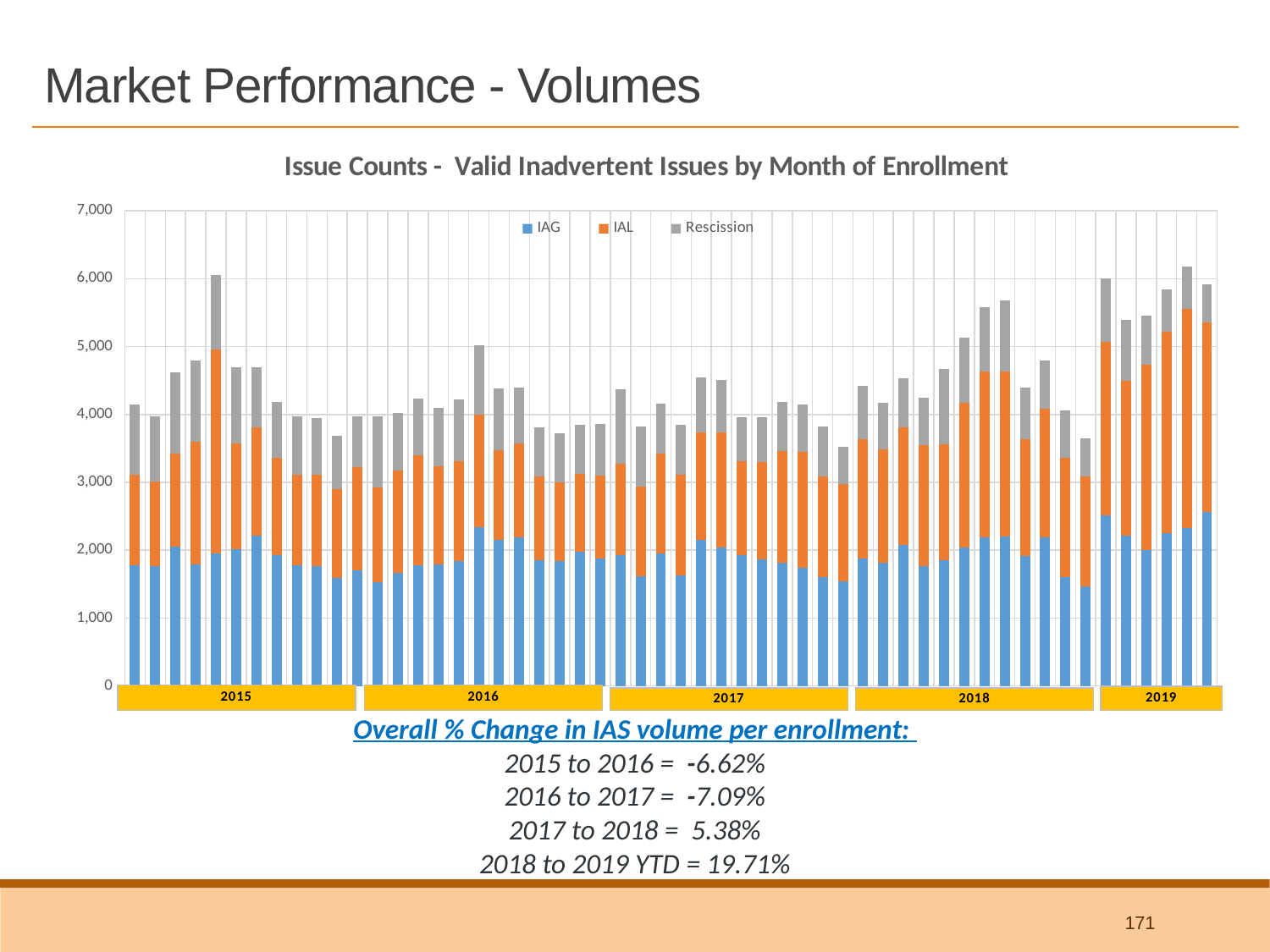
What is the title of the chart? Issue Counts - Valid Inadvertent Issues by Month of Enrollment Which is larger: the tallest bar in the 2019 group or the tallest bar in the 2017 group? The tallest bar in the 2019 group Is the IAG value of the last bar in the 2019 group greater or less than 2,000? greater According to the text below the chart, what is the overall % change in IAS volume per enrollment from 2016 to 2017? -7.09% Is the total of the last bar in the 2019 group greater or less than 5,000? greater Which series is plotted at the bottom of each stacked bar? IAG According to the text below the chart, what is the overall % change in IAS volume per enrollment from 2018 to 2019 YTD? 19.71% Do the bar totals generally rise or fall from the 2017 group to the 2019 group? rise How many series does the chart legend list? 3 Is the total of the shortest bar in the 2017 group greater or less than 4,000? less What kind of chart is shown on the slide? Stacked bar chart